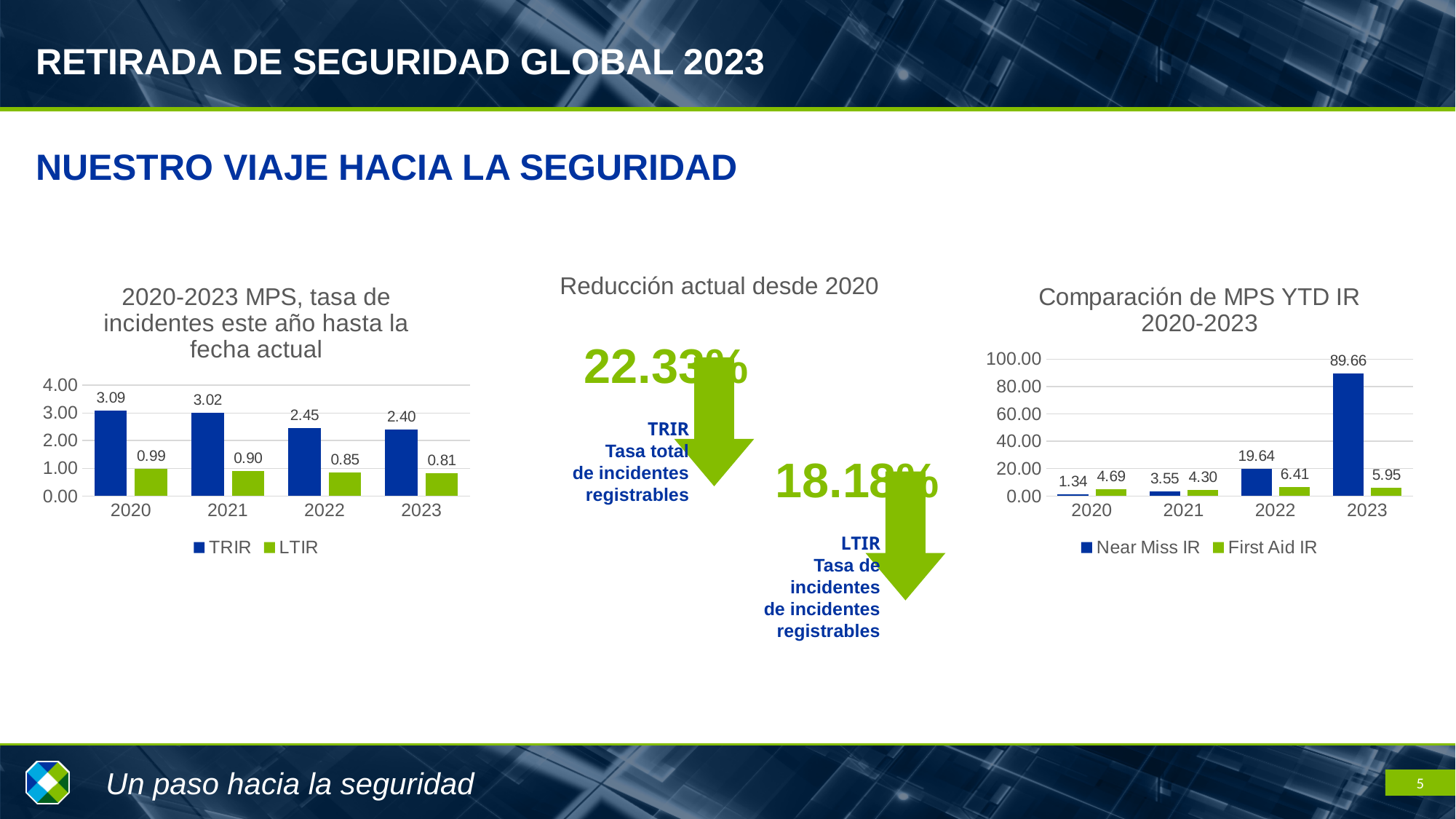
In the left chart (2020-2023 MPS, tasa de incidentes este año hasta la fecha actual), what is the TRIR value for 2020? 3.09 In the right chart (Comparación de MPS YTD IR 2020-2023), what is the First Aid IR value for 2022? 6.41 In the left chart (2020-2023 MPS, tasa de incidentes este año hasta la fecha actual), how many series does the legend list? 2 In the right chart (Comparación de MPS YTD IR 2020-2023), which year has the highest Near Miss IR value? 2023 In the right chart (Comparación de MPS YTD IR 2020-2023), what is the Near Miss IR value for 2023? 89.66 What kind of chart is the right chart (Comparación de MPS YTD IR 2020-2023)? bar chart In the left chart (2020-2023 MPS, tasa de incidentes este año hasta la fecha actual), what is the LTIR value for 2023? 0.81 In the right chart (Comparación de MPS YTD IR 2020-2023), which is larger for 2021: Near Miss IR or First Aid IR? First Aid IR In the left chart (2020-2023 MPS, tasa de incidentes este año hasta la fecha actual), does the TRIR series rise or fall from 2020 to 2023? fall In the left chart (2020-2023 MPS, tasa de incidentes este año hasta la fecha actual), what is the difference between the TRIR values for 2020 and 2023? 0.69 In the right chart (Comparación de MPS YTD IR 2020-2023), how many years are shown on the x axis? 4 In the left chart (2020-2023 MPS, tasa de incidentes este año hasta la fecha actual), which year has the lowest TRIR value? 2023